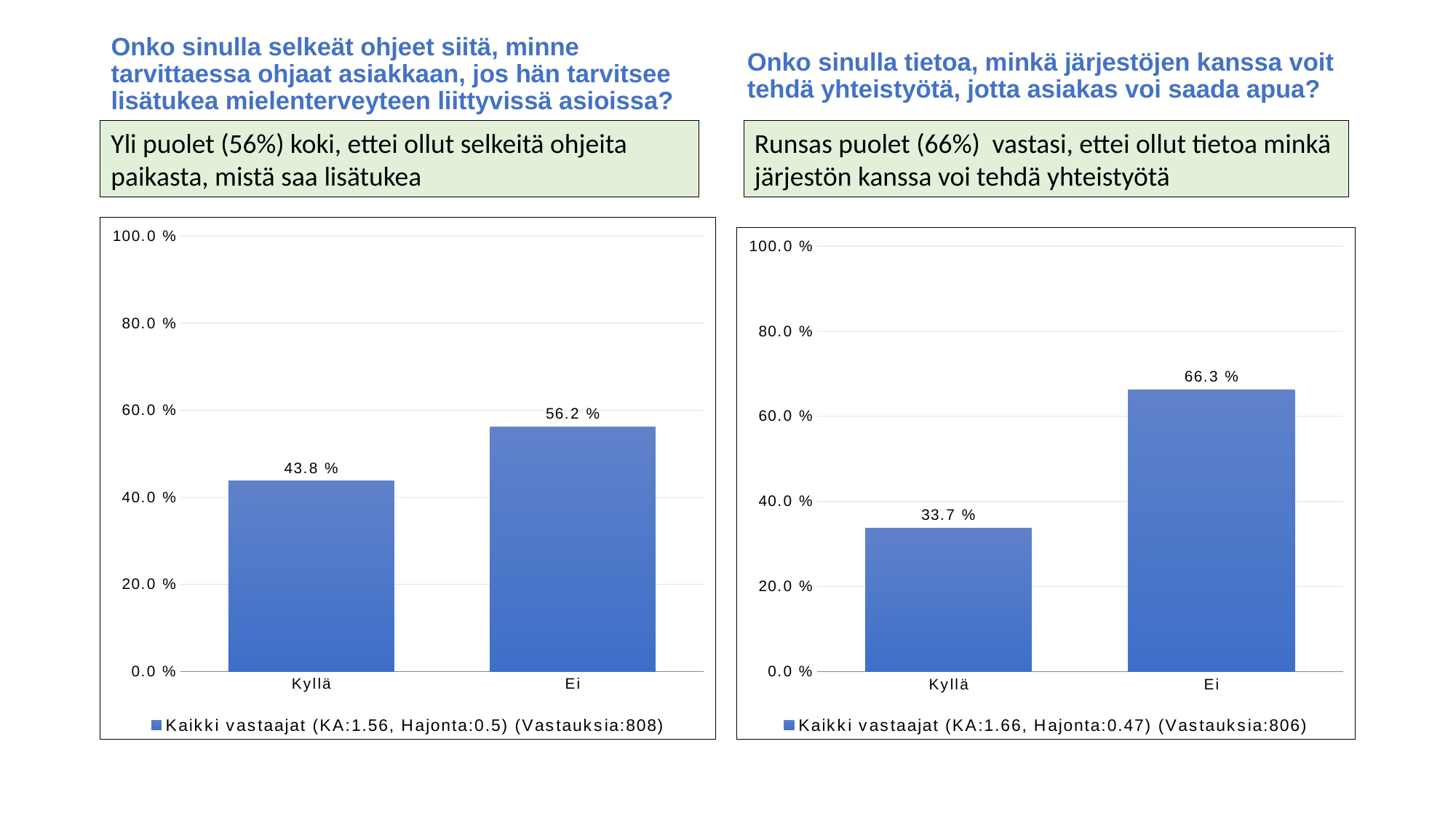
In the right chart, what is the difference between the values for Ei and Kyllä? 32.6 % In the left chart, what is the difference between the values for Ei and Kyllä? 12.4 % In the left chart, which category has the highest value? Ei In the left chart, what is the value for Ei? 56.2 % In the right chart, which category has the lowest value? Kyllä In the left chart, is the value for Kyllä greater or less than 40.0 %? greater In the left chart, what is the value for Kyllä? 43.8 % In the right chart, what is the value for Kyllä? 33.7 % In the right chart, what is the legend entry? Kaikki vastaajat (KA:1.66, Hajonta:0.47) (Vastauksia:806) In the right chart, what is the value for Ei? 66.3 % What kind of chart is the left chart? bar chart How many categories are shown in the right chart? 2